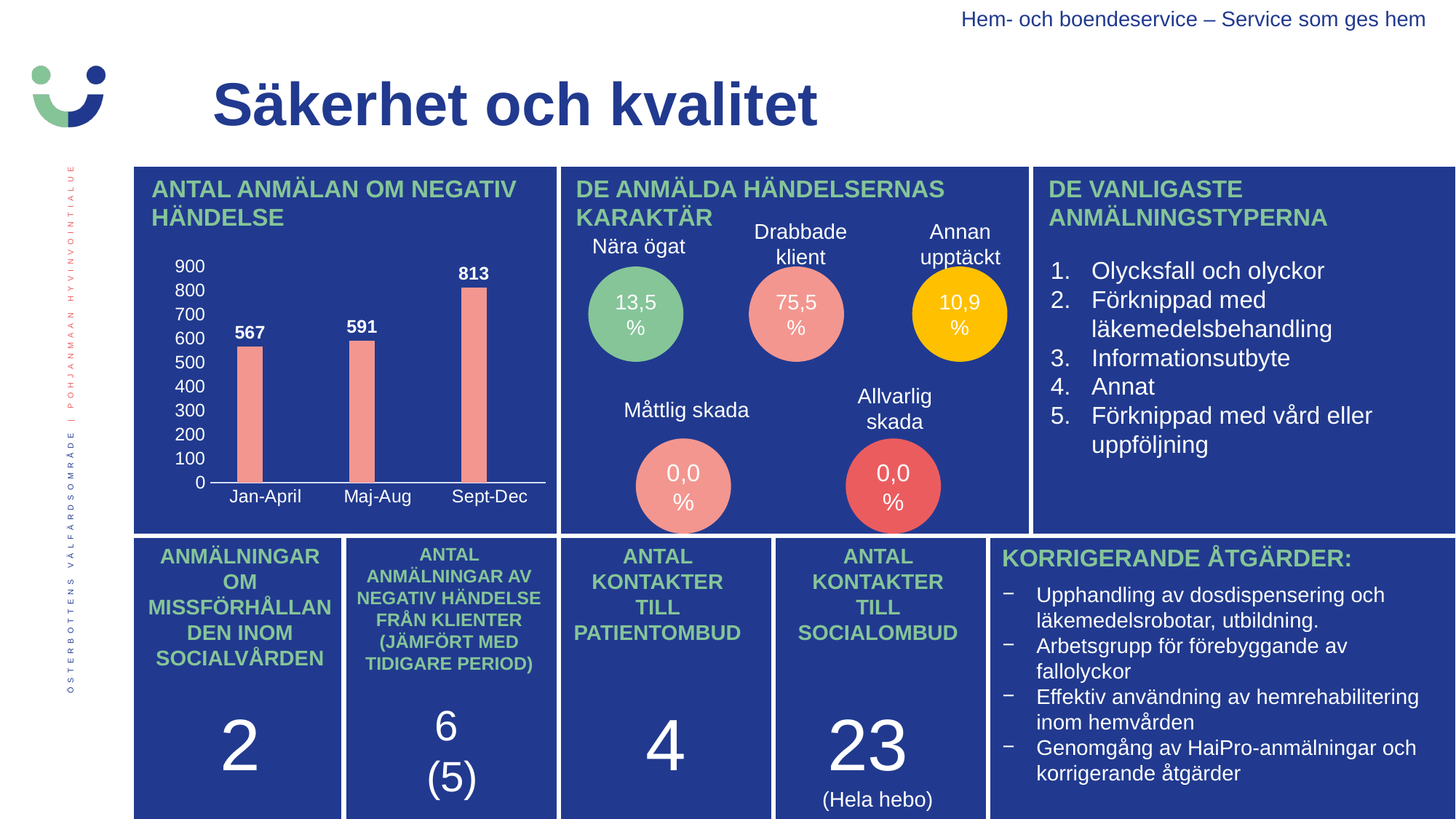
In the chart 'ANTAL ANMÄLAN OM NEGATIV HÄNDELSE', what is the difference between the Sept-Dec and Jan-April values? 246 In the chart 'ANTAL ANMÄLAN OM NEGATIV HÄNDELSE', what is the value for Maj-Aug? 591 In the chart 'ANTAL ANMÄLAN OM NEGATIV HÄNDELSE', what is the value for Sept-Dec? 813 In the chart 'ANTAL ANMÄLAN OM NEGATIV HÄNDELSE', is the value for Sept-Dec greater or less than 700? greater In the chart 'ANTAL ANMÄLAN OM NEGATIV HÄNDELSE', which period has the highest value? Sept-Dec In the chart 'ANTAL ANMÄLAN OM NEGATIV HÄNDELSE', which period has the lowest value? Jan-April In the chart 'ANTAL ANMÄLAN OM NEGATIV HÄNDELSE', do the values rise or fall from Jan-April to Sept-Dec? rise In the chart 'ANTAL ANMÄLAN OM NEGATIV HÄNDELSE', what is the difference between the Maj-Aug and Jan-April values? 24 In the chart 'ANTAL ANMÄLAN OM NEGATIV HÄNDELSE', what is the value for Jan-April? 567 In the chart 'ANTAL ANMÄLAN OM NEGATIV HÄNDELSE', which is larger, the value for Sept-Dec or the value for Maj-Aug? Sept-Dec How many periods (bars) are shown in the chart 'ANTAL ANMÄLAN OM NEGATIV HÄNDELSE'? 3 What kind of chart is 'ANTAL ANMÄLAN OM NEGATIV HÄNDELSE'? bar chart